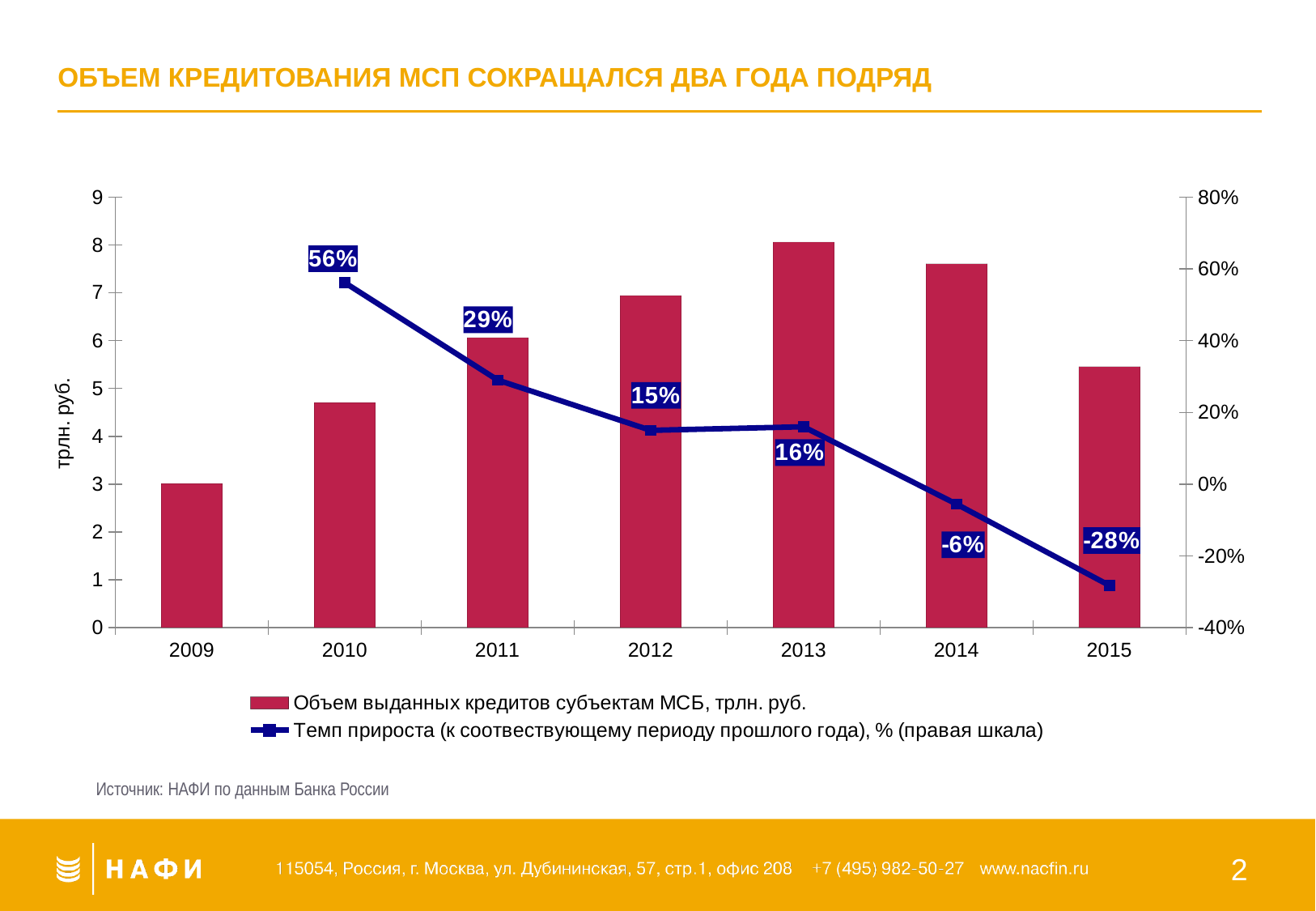
What is the growth rate (Темп прироста) shown for 2014? -6% What is the growth rate (Темп прироста) shown for 2010? 56% What is the difference between the growth rates for 2010 and 2011? 27 percentage points How many series does the legend list? 2 Which year has a taller bar for the volume of loans issued, 2013 or 2014? 2013 Does the growth rate line rise or fall from 2010 to 2015? fall Is the value of the bar for 2009 greater or less than 4 trillion rubles? less Is the value of the bar for 2013 greater or less than 7 trillion rubles? greater What is the growth rate (Темп прироста) shown for 2015? -28% Which year has the lowest growth rate on the line series? 2015 How many years are shown on the x axis? 7 Which year has the highest growth rate on the line series? 2010